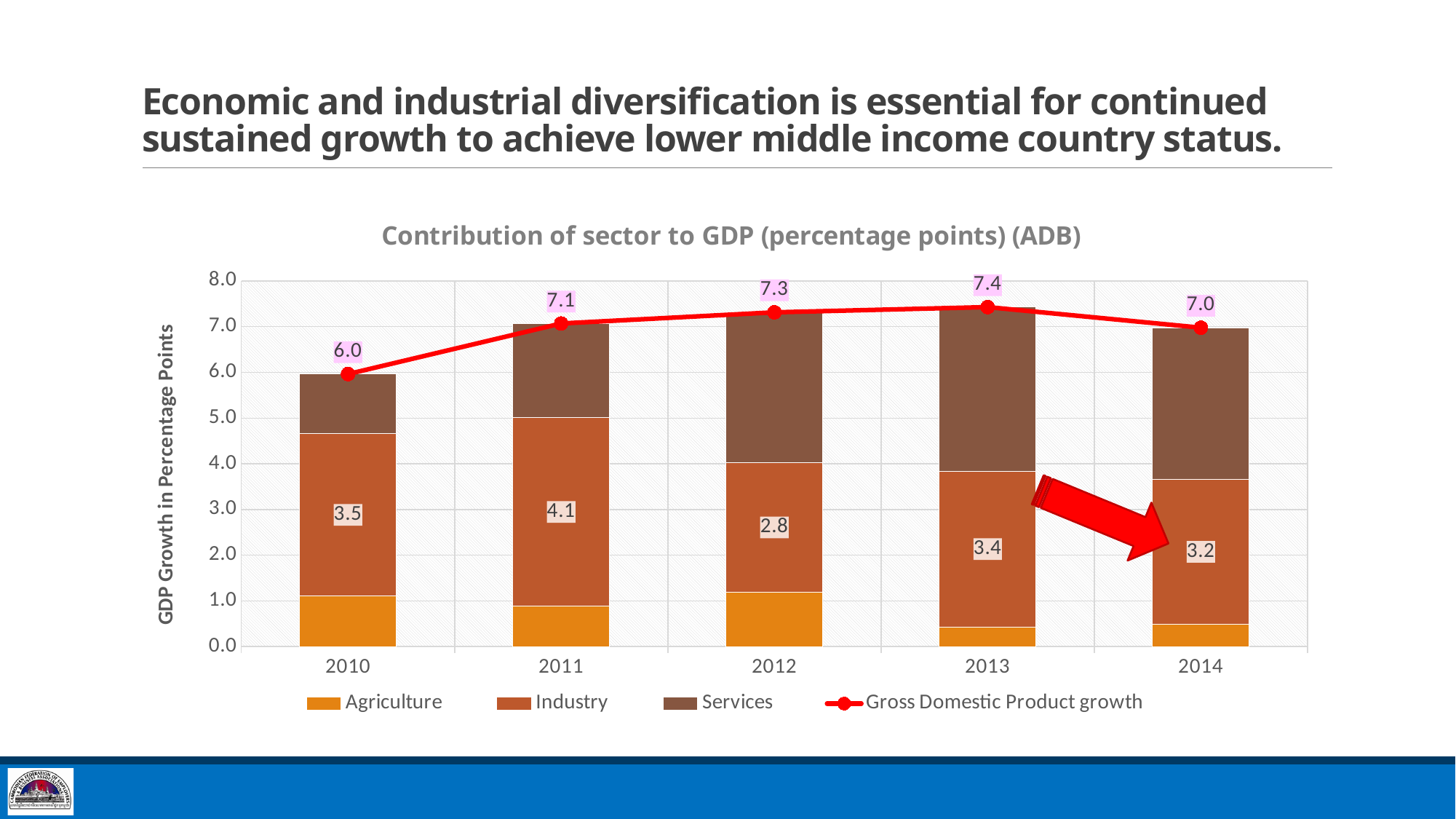
Which year has higher Gross Domestic Product growth, 2010 or 2014? 2014 Does Gross Domestic Product growth rise or fall from 2010 to 2013? rise In which year is the Industry contribution lowest? 2012 How many years are shown on the x axis? 5 Is the Agriculture contribution in 2013 greater or less than 1.0? less By how much did Gross Domestic Product growth increase from 2010 to 2013? 1.4 What is the Industry contribution to GDP in 2014? 3.2 How many series does the legend list? 4 What is the Industry contribution to GDP in 2011? 4.1 What is the difference between the Industry contribution in 2011 and in 2012? 1.3 What is the Gross Domestic Product growth value for 2013? 7.4 In which year is Gross Domestic Product growth highest? 2013